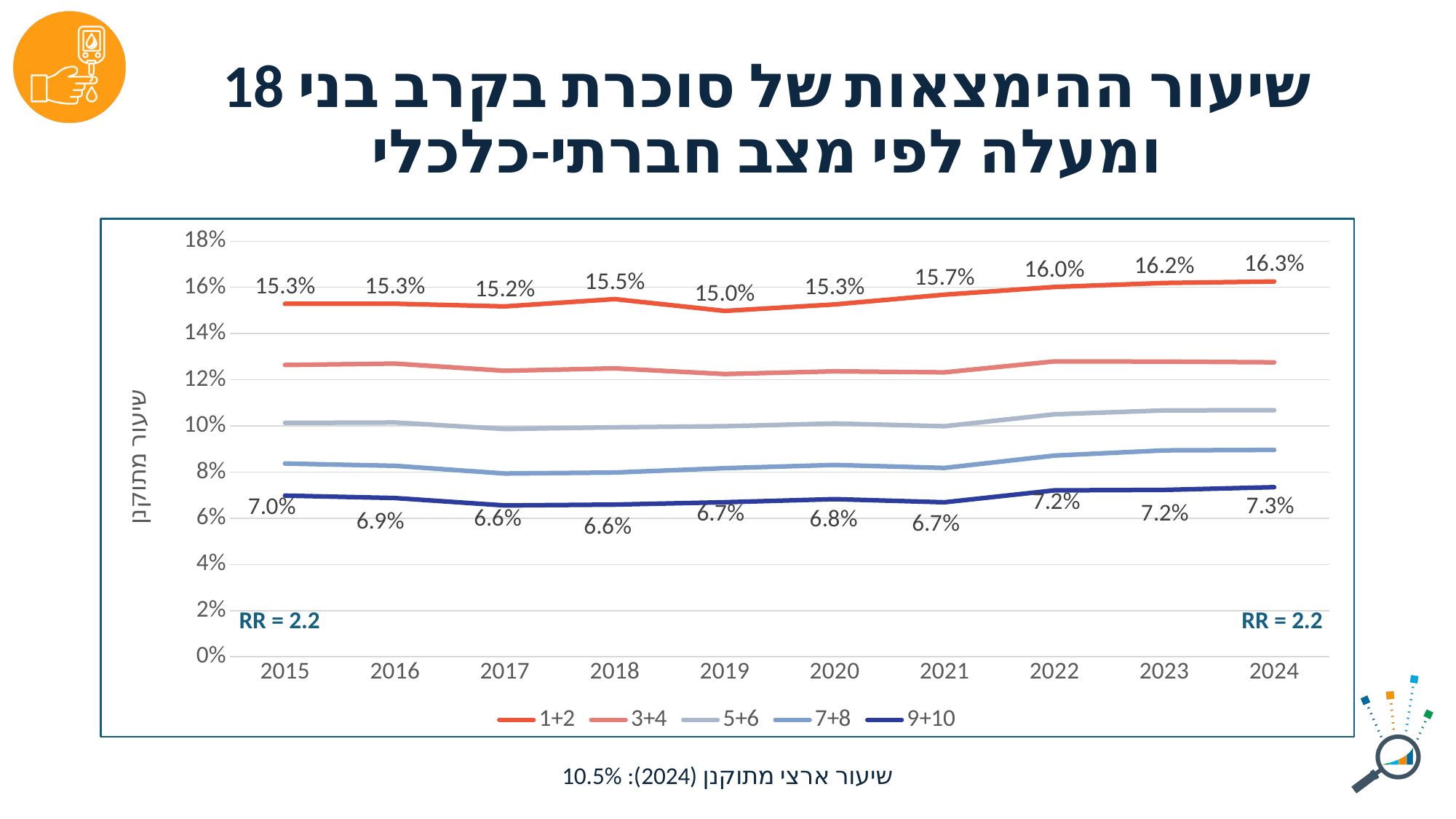
How many years are shown on the x axis? 10 In which year is the 1+2 series at its lowest? 2019 What is the value for the 1+2 series in 2024? 16.3% In which year is the 1+2 series at its highest? 2024 What kind of chart is shown on the slide? line chart Which series has the higher value in 2021, 1+2 or 9+10? 1+2 What is the difference between the 1+2 value in 2024 and in 2015? 1.0% What is the value for the 9+10 series in 2015? 7.0% How many series does the legend list? 5 What is the value for the 1+2 series in 2019? 15.0% Is the value for the 3+4 series in 2024 greater or less than 12%? greater What is the difference between the 1+2 and 9+10 series in 2024? 9.0%